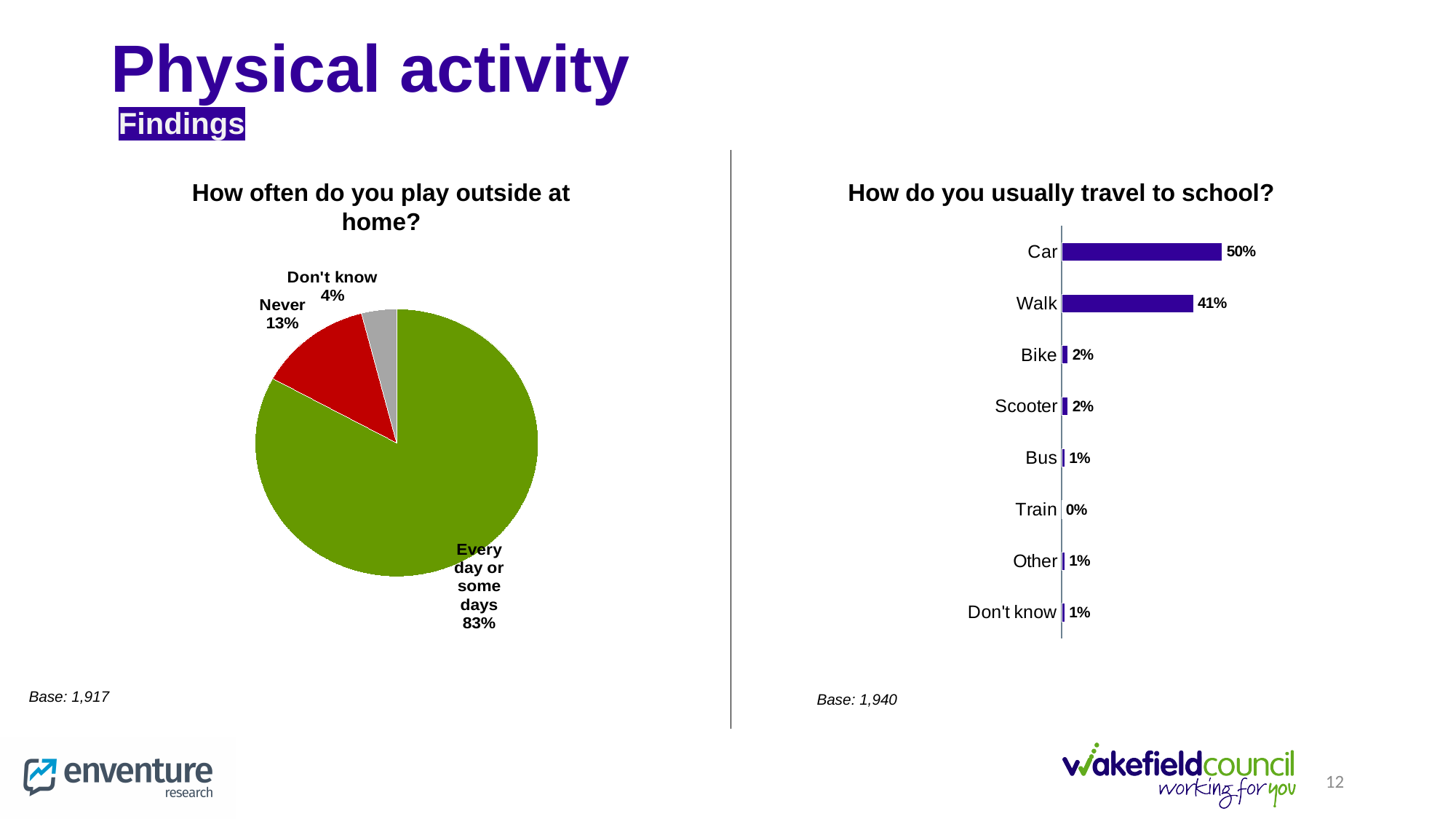
In the 'How do you usually travel to school?' chart, what is the difference between the Car and Walk percentages? 9 percentage points In the 'How often do you play outside at home?' chart, what percentage answered 'Never'? 13% In the 'How often do you play outside at home?' chart, which response has the smallest share? Don't know In the 'How often do you play outside at home?' chart, what colour is the 'Never' slice? Red In the 'How do you usually travel to school?' chart, what percentage of respondents travel by car? 50% In the 'How do you usually travel to school?' chart, what percentage walk to school? 41% In the 'How often do you play outside at home?' chart, what is the difference between the 'Never' and 'Don't know' shares? 9 percentage points What type of chart is 'How do you usually travel to school?'? Bar chart In the 'How do you usually travel to school?' chart, which mode of travel has the lowest value? Train What type of chart is 'How often do you play outside at home?'? Pie chart In the 'How do you usually travel to school?' chart, how many travel categories are shown? 8 In the 'How often do you play outside at home?' chart, what percentage of respondents answered 'Every day or some days'? 83%